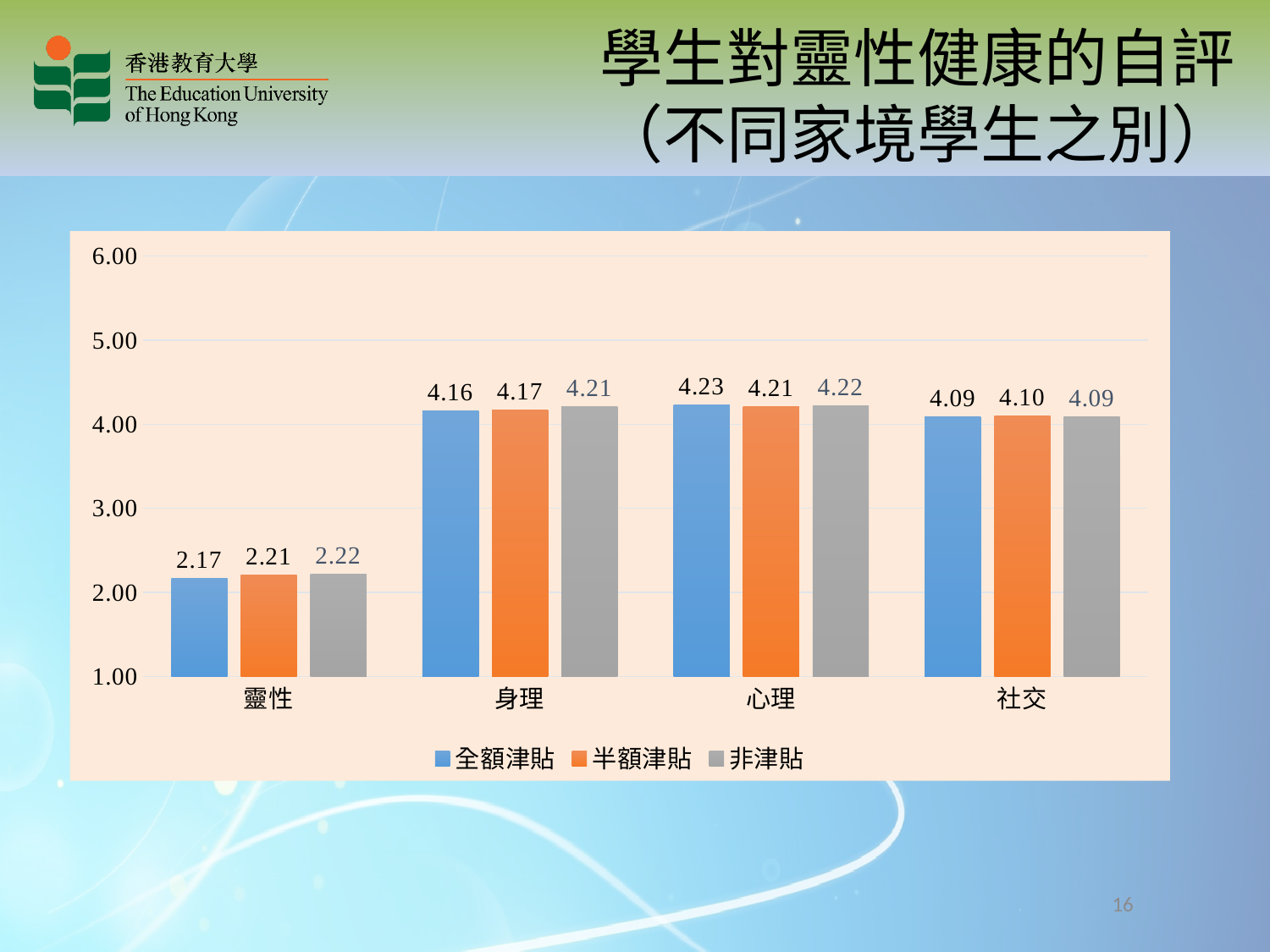
What is the value for 全額津貼 in the 靈性 category? 2.17 What is the difference between the 非津貼 and 全額津貼 values in the 身理 category? 0.05 Which category has the highest value for 全額津貼? 心理 How many series does the legend list? 3 What is the value for 半額津貼 in the 社交 category? 4.10 What is the difference between the 非津貼 and 全額津貼 values in the 靈性 category? 0.05 Is the value for 半額津貼 in the 靈性 category greater or less than 3.00? less Which category has the lowest value for 全額津貼? 靈性 Which is larger in the 心理 category: the value for 全額津貼 or the value for 半額津貼? 全額津貼 What is the value for 非津貼 in the 身理 category? 4.21 How many categories are shown on the x axis? 4 What kind of chart is shown on the slide? bar chart